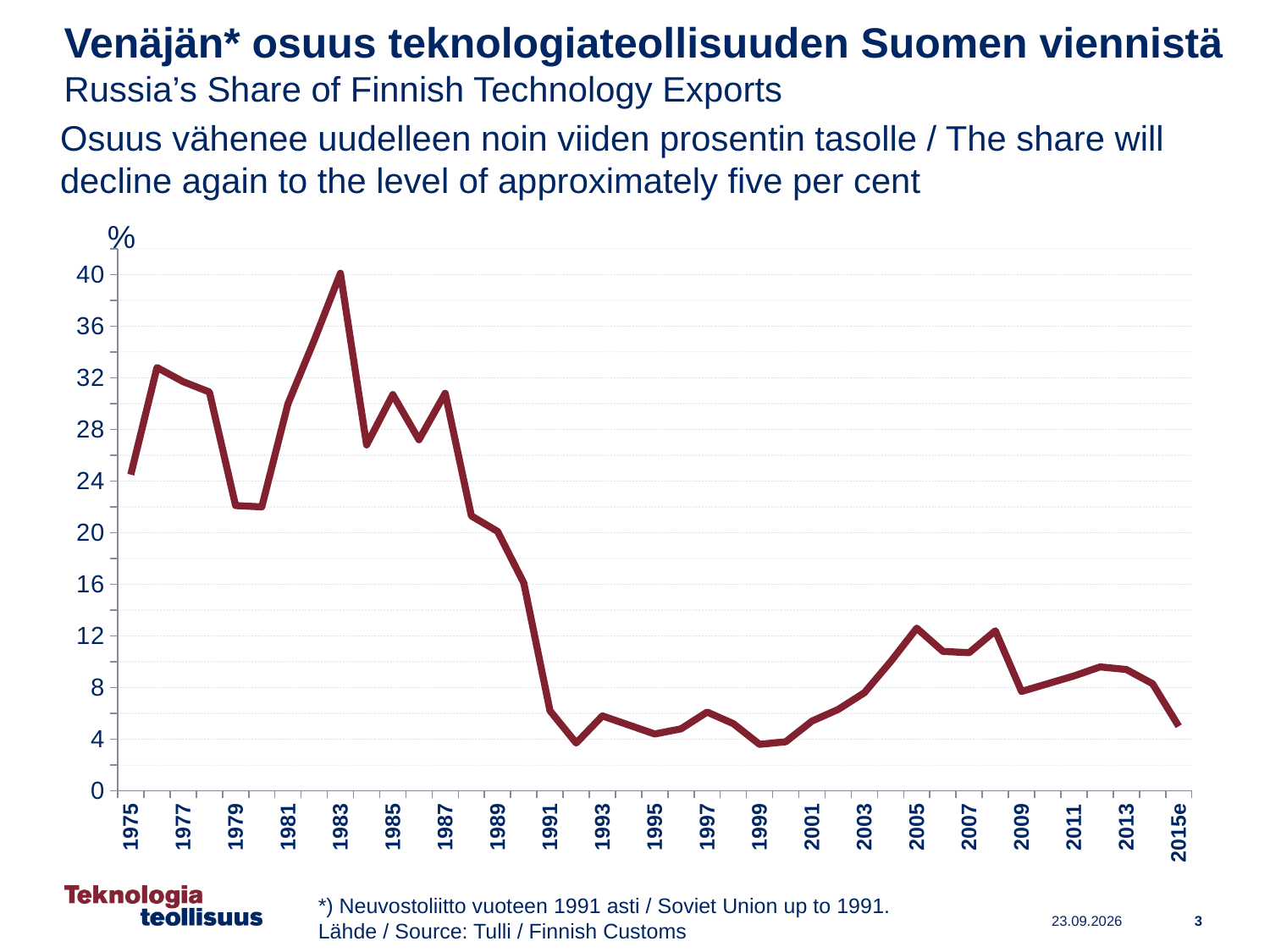
Is the value for 1975 greater or less than 20? greater Is the value for 1989 greater or less than 16? greater What kind of chart is shown on the slide? line chart Is the value for 2015e greater or less than 8? less What is the English title of the chart on the slide? Russia's Share of Finnish Technology Exports What unit is shown at the top of the y axis? % Does the share rise or fall between 1983 and 1992? fall In which year does Russia's share of Finnish technology exports reach its highest value? 1983 Which year has the larger value, 1977 or 1979? 1977 Which year has the larger value, 1995 or 2005? 2005